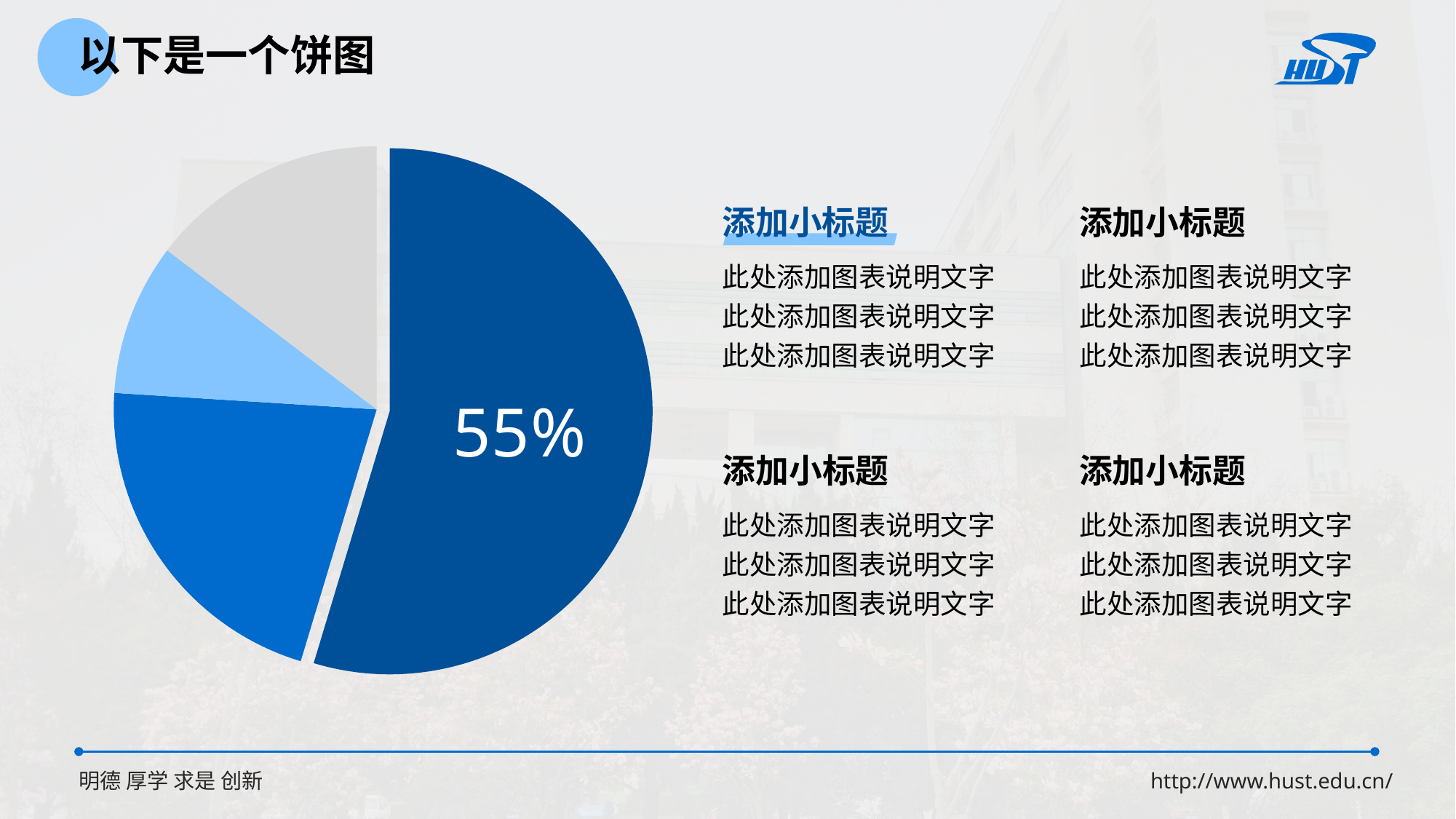
Which is larger, the dark blue slice or the light blue slice? the dark blue slice What colour is the slice labelled 55%? dark blue Does the labelled slice account for more or less than half of the pie? more Which slice of the pie chart is the smallest? the light blue slice How many slices does the pie chart have? 4 What share of the pie does the dark blue slice represent? 55% What kind of chart is shown on the slide? pie chart Which slice of the pie chart is the largest? the dark blue slice (55%) What percentage is printed on the largest slice of the pie chart? 55% What is the title of the slide containing the pie chart? 以下是一个饼图 Which is larger, the dark blue slice or the grey slice? the dark blue slice